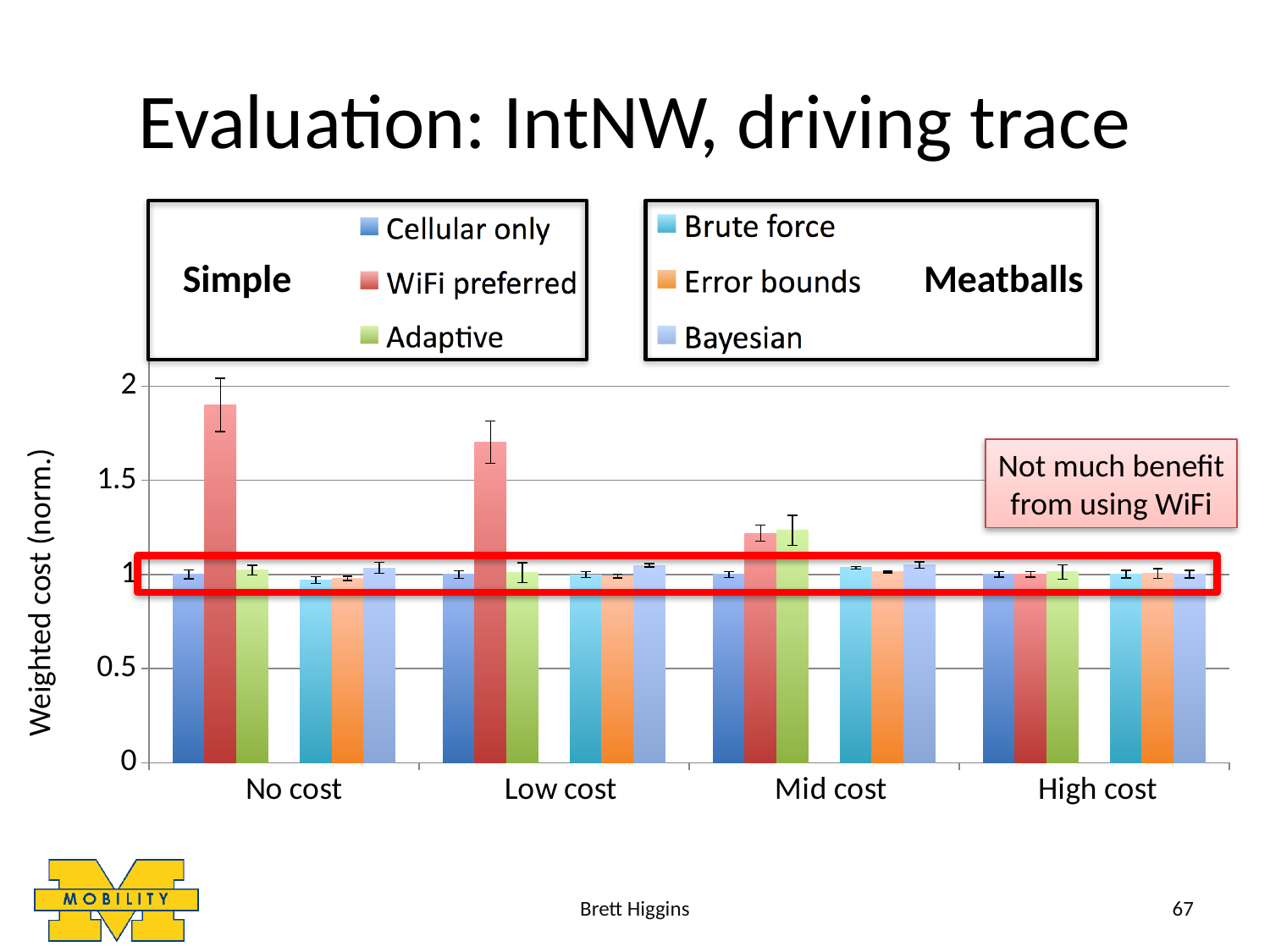
Is the value for WiFi preferred at Mid cost greater or less than 1.5? less Which is larger: the WiFi preferred bar at No cost or the WiFi preferred bar at Low cost? No cost What is the label on the y axis? Weighted cost (norm.) Is the value for WiFi preferred at No cost greater or less than 1.5? greater What kind of chart is shown on the slide? bar chart Is the value for Cellular only at No cost greater or less than 1.5? less How many cost categories are shown on the x axis? 4 How many series do the two legends list in total? 6 Does the WiFi preferred series rise or fall from No cost to High cost? fall Which three series are grouped under the 'Meatballs' legend? Brute force, Error bounds, Bayesian Which series has the tallest bar in the No cost category? WiFi preferred